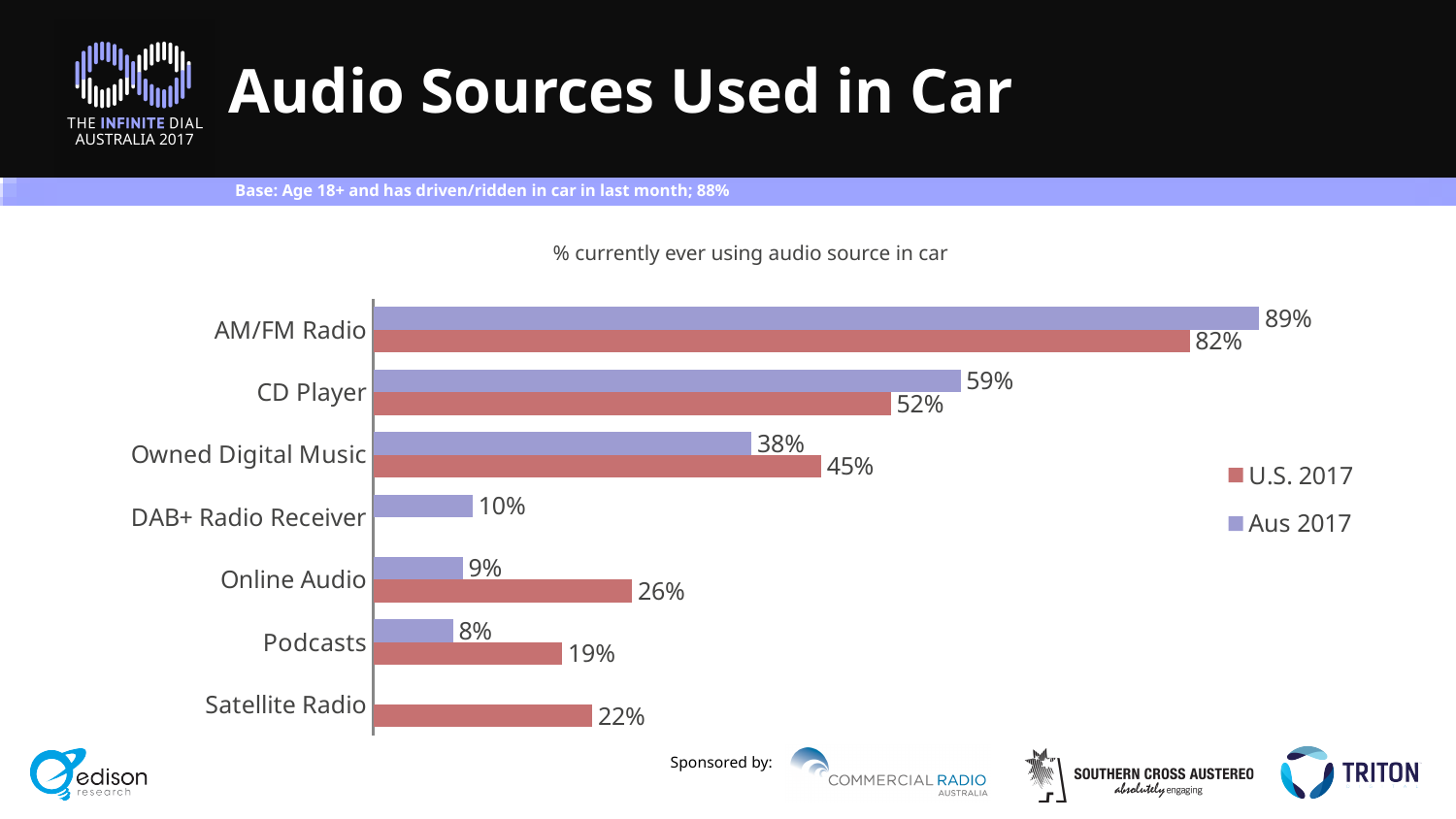
How many series does the legend list? 2 Which audio source has the lowest U.S. 2017 value shown? Podcasts What is the difference between the Aus 2017 and U.S. 2017 values for CD Player? 7% How many audio source categories are listed on the chart? 7 Which is larger for Owned Digital Music: the U.S. 2017 value or the Aus 2017 value? U.S. 2017 What kind of chart is shown on the slide? Bar chart What is the U.S. 2017 value for Online Audio? 26% What is the Aus 2017 value for Podcasts? 8% Which audio source has no Aus 2017 bar shown? Satellite Radio What percentage of Australians in 2017 use AM/FM Radio in the car? 89% Which audio source has the highest Aus 2017 value? AM/FM Radio What colour represents the U.S. 2017 series in the legend? Red